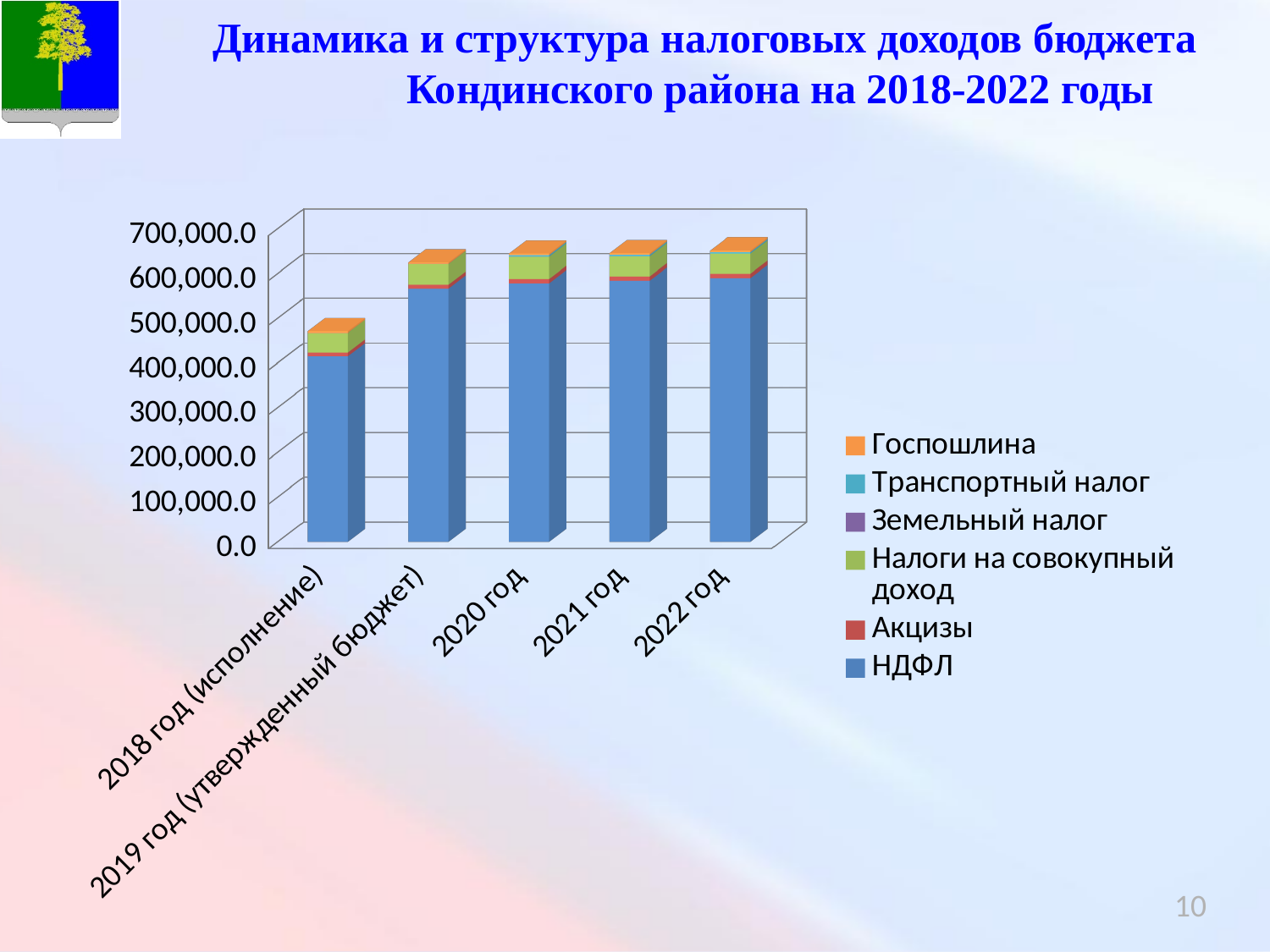
Which is larger: the total bar for 2018 год (исполнение) or for 2019 год (утвержденный бюджет)? 2019 год (утвержденный бюджет) Is the total bar for 2022 год greater or less than 700,000.0? less Is the total bar for 2020 год greater or less than 600,000.0? greater Is the НДФЛ segment for 2018 год (исполнение) greater or less than 500,000.0? less Which series is listed first in the chart legend? Госпошлина How many categories (years) are shown on the x axis of the chart? 5 Which category has the lowest total bar in the chart? 2018 год (исполнение) Which series forms the largest (bottom) segment of every bar in the chart? НДФЛ How many series does the chart legend list? 6 What kind of chart is shown on the slide? Stacked bar chart